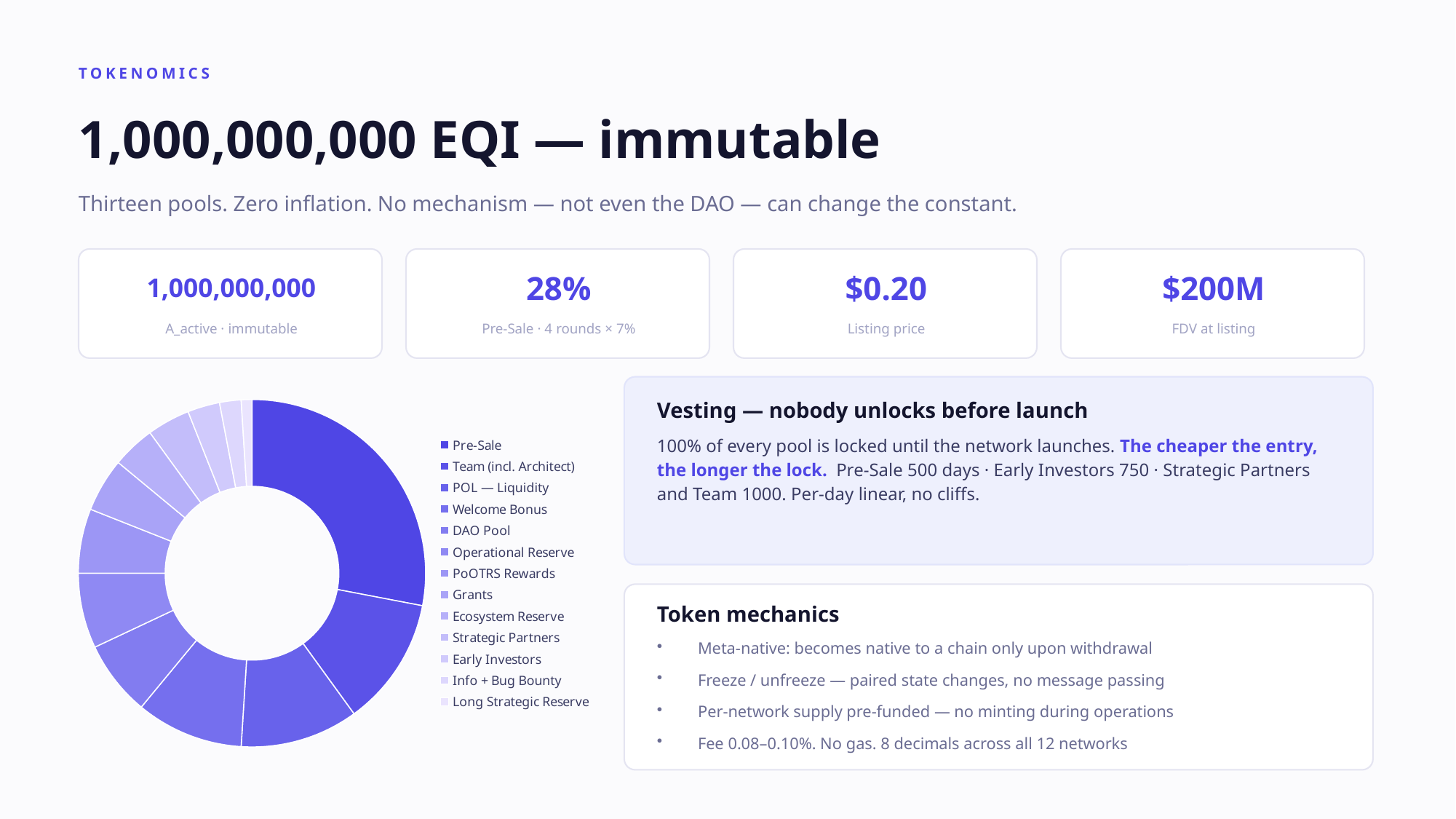
How many entries does the legend of the donut chart list? 13 Which slice is larger in the donut chart: Team (incl. Architect) or Long Strategic Reserve? Team (incl. Architect) Which slice is larger in the donut chart: Pre-Sale or DAO Pool? Pre-Sale What is the last entry listed in the donut chart's legend? Long Strategic Reserve Which category has the largest slice in the donut chart? Pre-Sale What is the first entry listed in the donut chart's legend? Pre-Sale Which slice is larger in the donut chart: POL — Liquidity or Info + Bug Bounty? POL — Liquidity What kind of chart is shown on the left of the slide? Donut (pie) chart How many categories (pools) does the donut chart show? 13